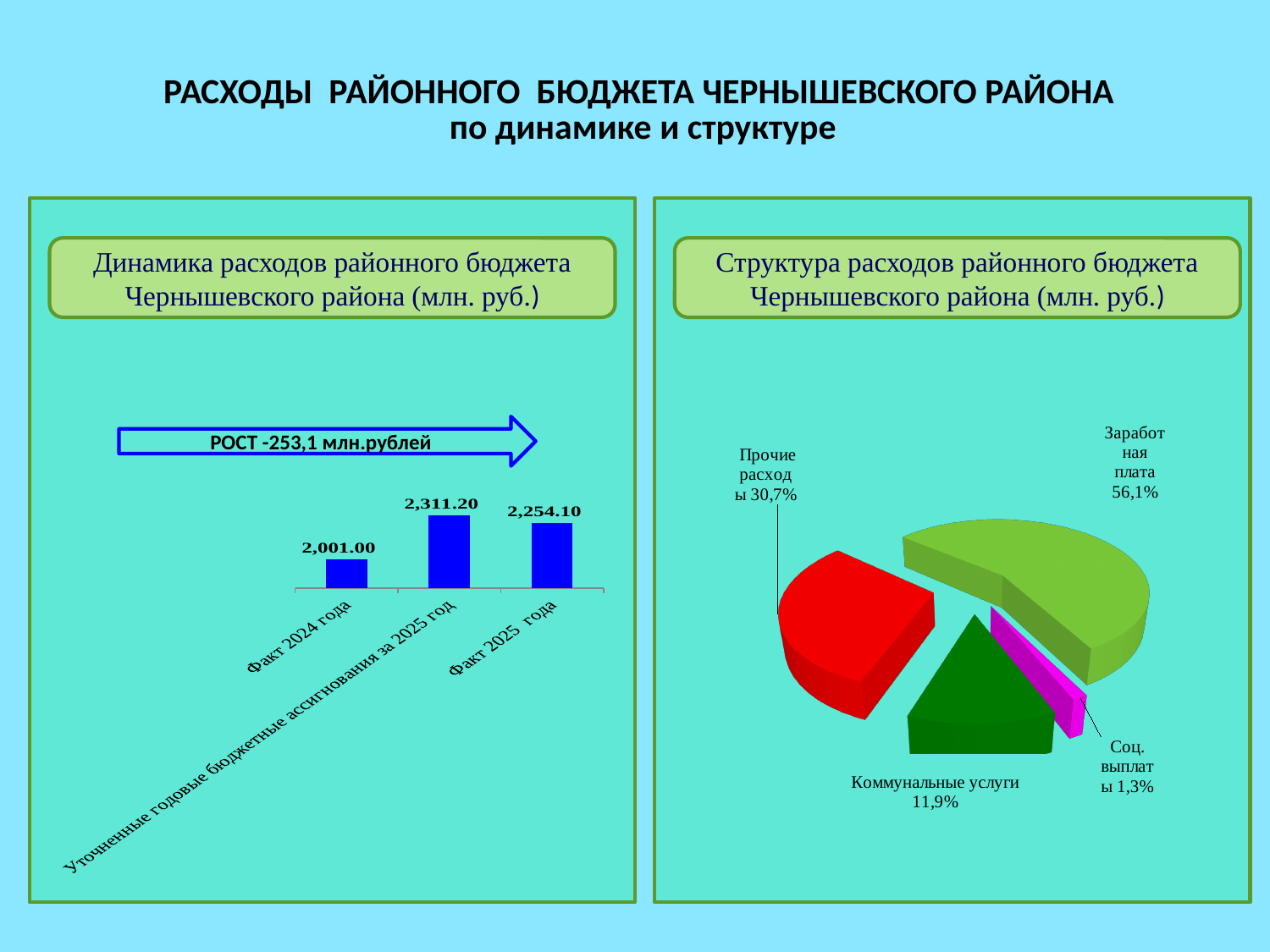
In the left chart (Динамика расходов районного бюджета), which category has the highest value? Уточненные годовые бюджетные ассигнования за 2025 год In the left chart (Динамика расходов районного бюджета), how many bars are plotted? 3 In the right chart (Структура расходов районного бюджета), what share does Заработная плата have? 56,1% In the left chart (Динамика расходов районного бюджета), what is the value for Уточненные годовые бюджетные ассигнования за 2025 год? 2,311.20 In the left chart (Динамика расходов районного бюджета), what is the value for Факт 2025 года? 2,254.10 In the right chart (Структура расходов районного бюджета), which slice is the smallest? Соц. выплаты In the left chart (Динамика расходов районного бюджета), what is the difference between Факт 2025 года and Факт 2024 года? 253.10 In the right chart (Структура расходов районного бюджета), what share does Коммунальные услуги have? 11,9% In the left chart (Динамика расходов районного бюджета), which category has the lowest value? Факт 2024 года In the right chart (Структура расходов районного бюджета), which is larger: Прочие расходы or Коммунальные услуги? Прочие расходы What kind of chart is the left chart (Динамика расходов районного бюджета)? Bar chart In the left chart (Динамика расходов районного бюджета), what is the value for Факт 2024 года? 2,001.00